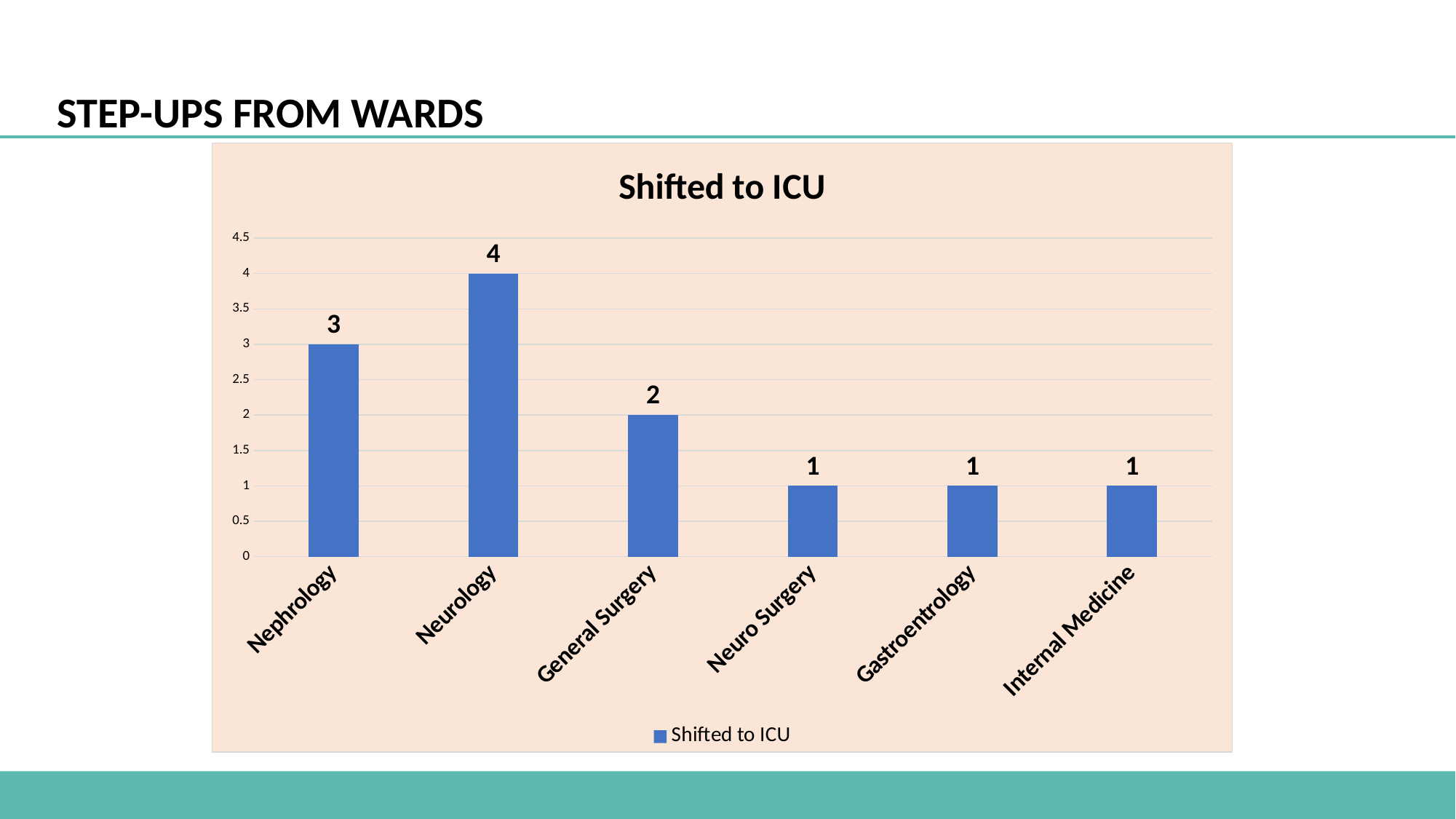
Is the value for Neurology greater or less than 3.5? greater How many categories are shown on the x axis? 6 How many series does the legend list? 1 What is the value for Gastroentrology? 1 What is the value for Nephrology? 3 What kind of chart is shown? bar chart Which is larger, the value for Nephrology or the value for Neuro Surgery? Nephrology What is the value for Neurology? 4 What is the title of the chart? Shifted to ICU What is the value for General Surgery? 2 Which category has the highest value? Neurology What is the difference between the values for Neurology and General Surgery? 2